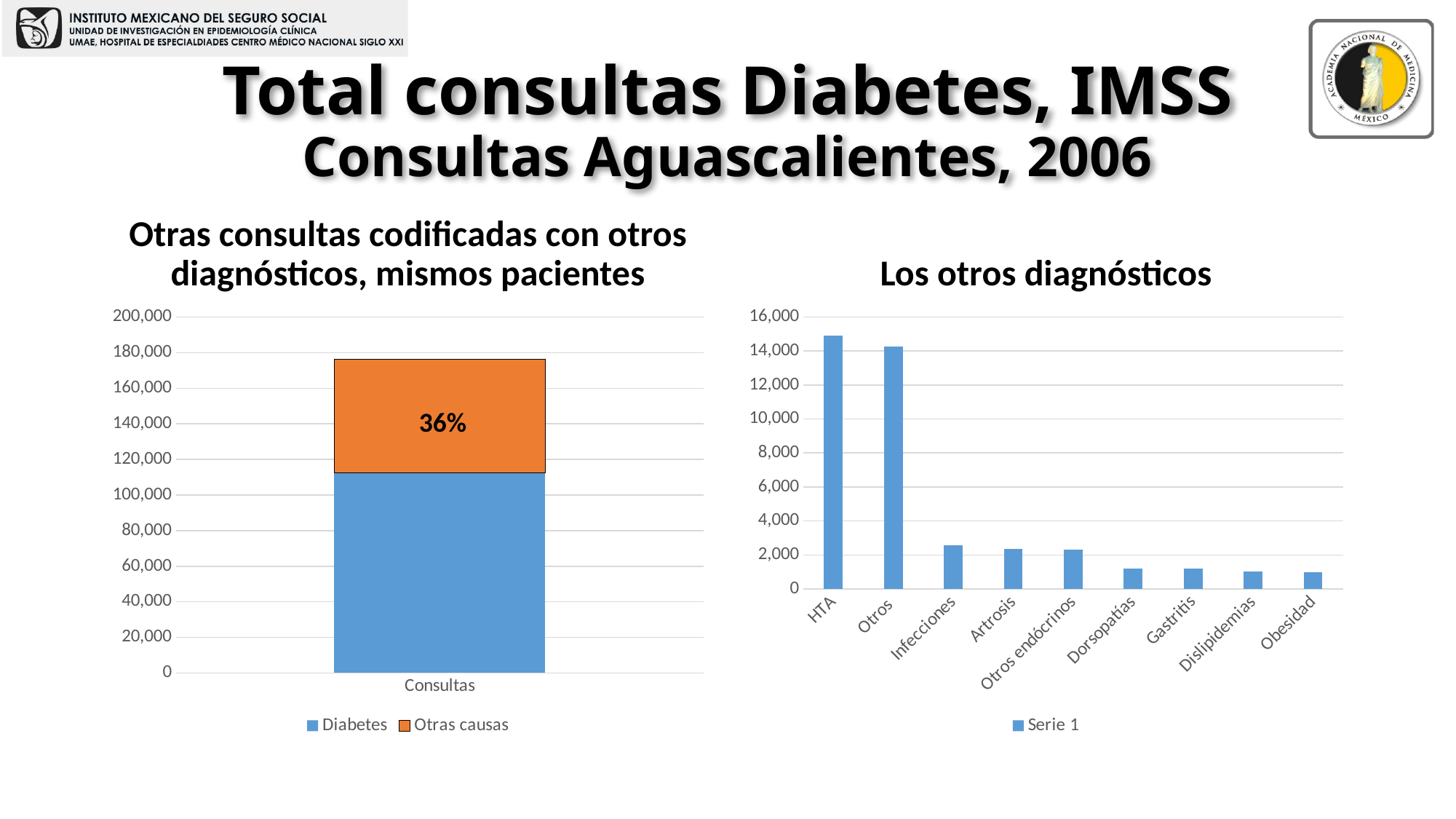
How many series does the legend list for the chart titled "Los otros diagnósticos"? 1 In the chart titled "Los otros diagnósticos", which is larger, the value for Otros or the value for Artrosis? Otros In the chart titled "Los otros diagnósticos", is the value for HTA greater or less than 14,000? greater How many categories are shown on the x axis of the chart titled "Los otros diagnósticos"? 9 In the chart titled "Los otros diagnósticos", do the values generally rise or fall from left to right along the x axis? fall In the chart titled "Otras consultas codificadas con otros diagnósticos, mismos pacientes", is the Diabetes value for Consultas greater or less than 100,000? greater How many series does the legend list for the chart titled "Otras consultas codificadas con otros diagnósticos, mismos pacientes"? 2 What kind of chart is the chart titled "Los otros diagnósticos"? bar chart In the chart titled "Otras consultas codificadas con otros diagnósticos, mismos pacientes", what colour represents Otras causas? orange In the chart titled "Otras consultas codificadas con otros diagnósticos, mismos pacientes", what percentage label is printed on the Otras causas segment? 36% In the chart titled "Los otros diagnósticos", is the value for Infecciones greater or less than 2,000? greater